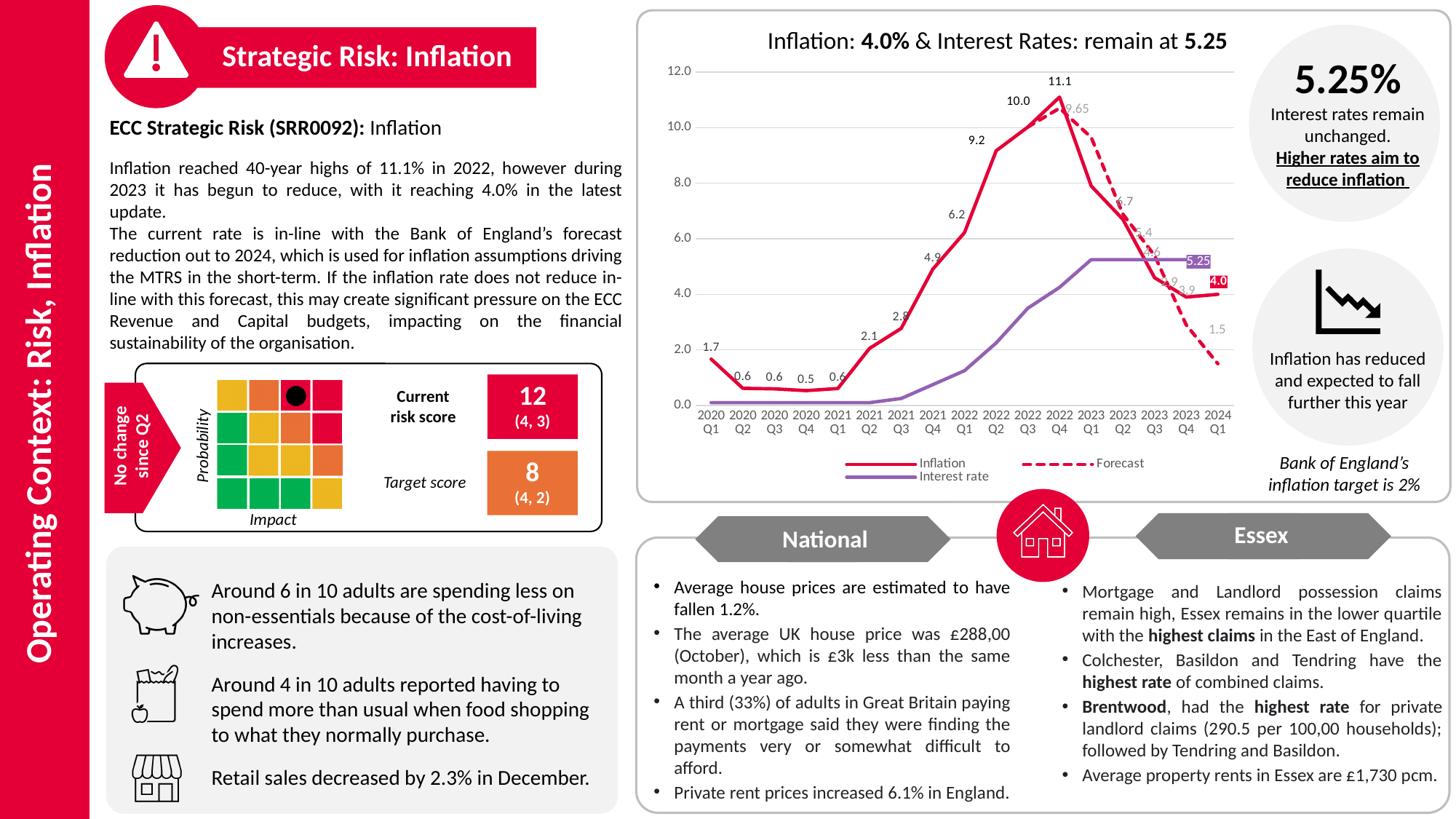
How many series does the chart legend list? 3 What is the inflation value for 2020 Q1? 1.7 In which quarter does inflation reach its highest value? 2022 Q4 What is the highest inflation value shown on the chart? 11.1 What is the inflation value for 2022 Q2? 9.2 Is the interest rate value for 2021 Q4 greater or less than 2.0? less What is the inflation value for 2022 Q1? 6.2 Which is larger, the inflation value for 2022 Q2 or for 2021 Q4? 2022 Q2 Does inflation rise or fall between 2021 Q1 and 2022 Q4? rise What is the difference between the inflation values for 2022 Q4 and 2022 Q3? 1.1 What is the inflation value for 2021 Q4? 4.9 What type of chart is shown on the slide? line chart